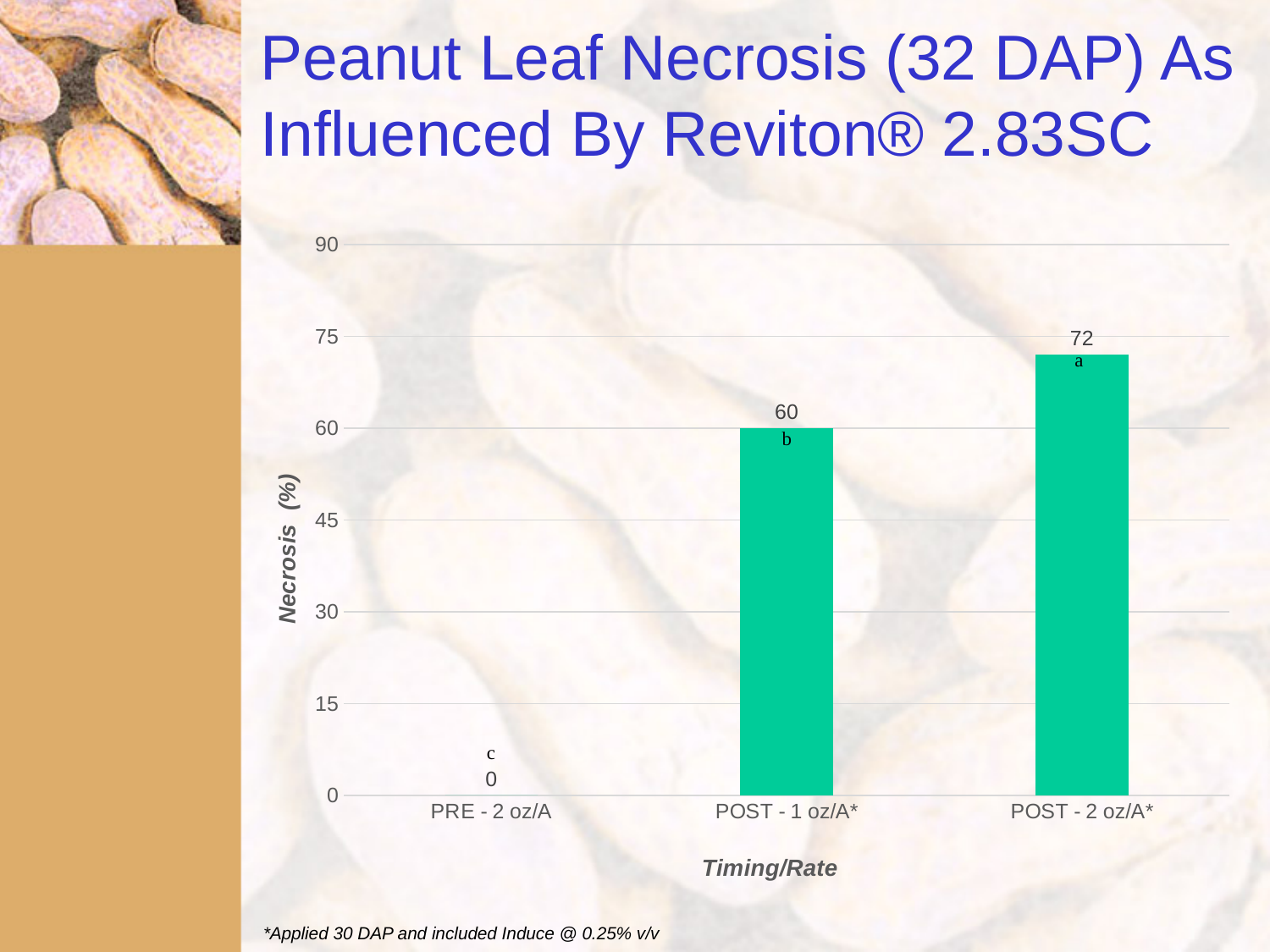
How many timing/rate categories are shown on the chart? 3 What is the necrosis value for PRE - 2 oz/A? 0 What is the label of the y axis? Necrosis (%) What is the necrosis value for POST - 2 oz/A*? 72 Which has higher necrosis, POST - 1 oz/A* or POST - 2 oz/A*? POST - 2 oz/A* What kind of chart is shown on the slide? bar chart What is the label of the x axis? Timing/Rate Which timing/rate has the lowest necrosis? PRE - 2 oz/A What is the necrosis value for POST - 1 oz/A*? 60 Is the necrosis value for POST - 1 oz/A* greater or less than 45? greater What is the difference in necrosis between POST - 2 oz/A* and POST - 1 oz/A*? 12 Which timing/rate has the highest necrosis? POST - 2 oz/A*